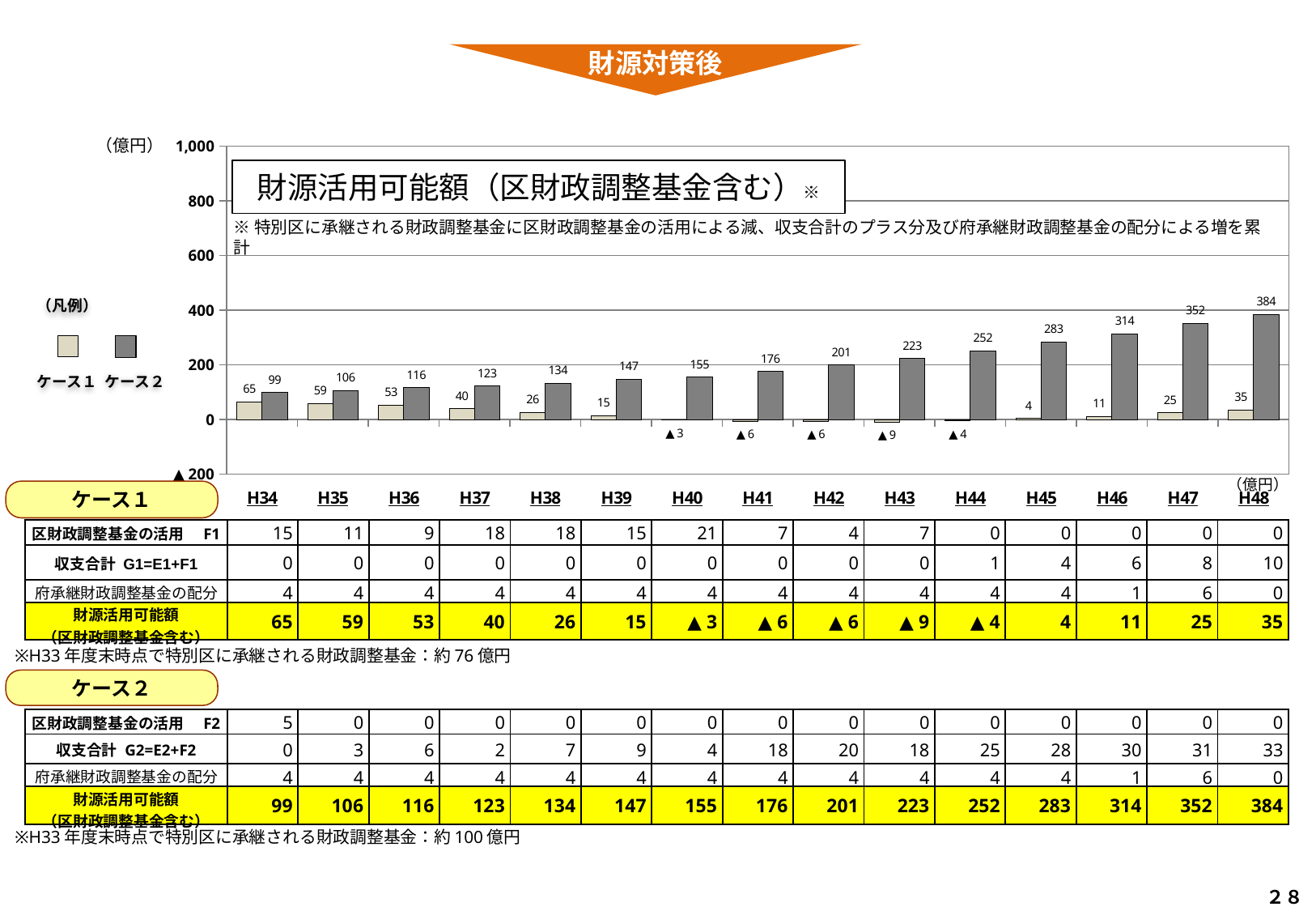
In which year is the value for ケース2 highest? H48 What is the value for ケース2 in H40? 155 How many years (categories) are shown on the x axis of the chart? 15 What is the value for ケース2 in H48? 384 In which year is the value for ケース1 lowest? H43 What type of chart is shown on the slide? bar chart How many series does the legend list? 2 What is the difference between ケース2 and ケース1 in H48? 349 What is the value for ケース1 in H43? ▲9 What is the value for ケース1 in H34? 65 Which is larger in H36, the value for ケース1 or ケース2? ケース2 Do the values for ケース2 rise or fall from H34 to H48? rise